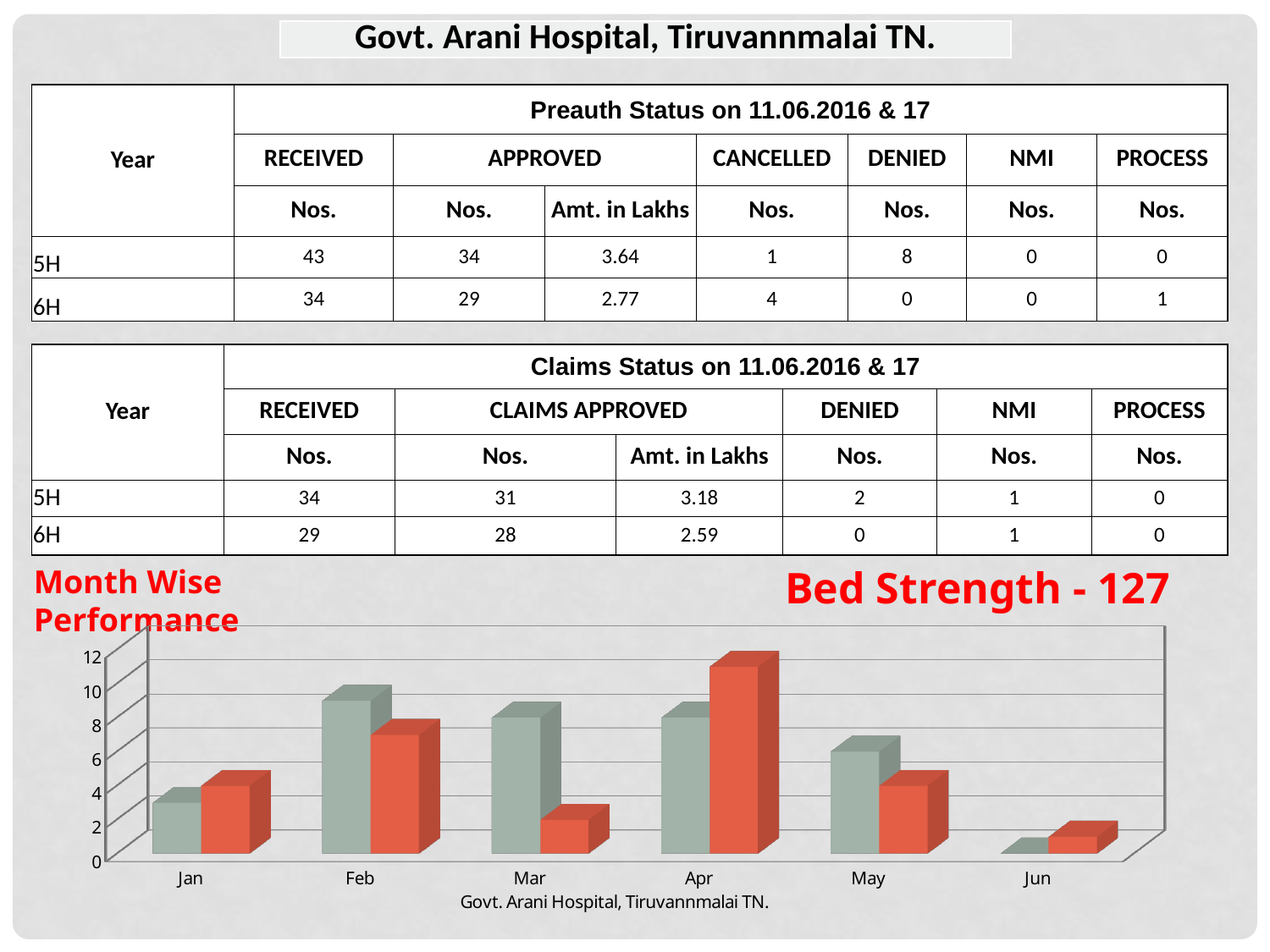
In the Month Wise Performance chart, which month has the tallest grey bar? Feb What text appears below the x axis of the Month Wise Performance chart? Govt. Arani Hospital, Tiruvannmalai TN. In the Month Wise Performance chart, which month has the tallest red bar? Apr In the Month Wise Performance chart, do the red bars rise or fall from Apr to Jun? fall What kind of chart is shown under the heading "Month Wise Performance"? bar chart In the Month Wise Performance chart, is the red bar for Mar greater or less than 4? less In the Month Wise Performance chart, which month has the shortest grey bar? Jun How many months are shown on the x axis of the Month Wise Performance chart? 6 In the Month Wise Performance chart, is the grey bar for Feb greater or less than 8? greater In the Month Wise Performance chart, is the red bar for Apr greater or less than 10? greater In the Month Wise Performance chart, which month has the shortest red bar? Jun In the Month Wise Performance chart, for Mar, which bar is taller, the grey one or the red one? the grey one